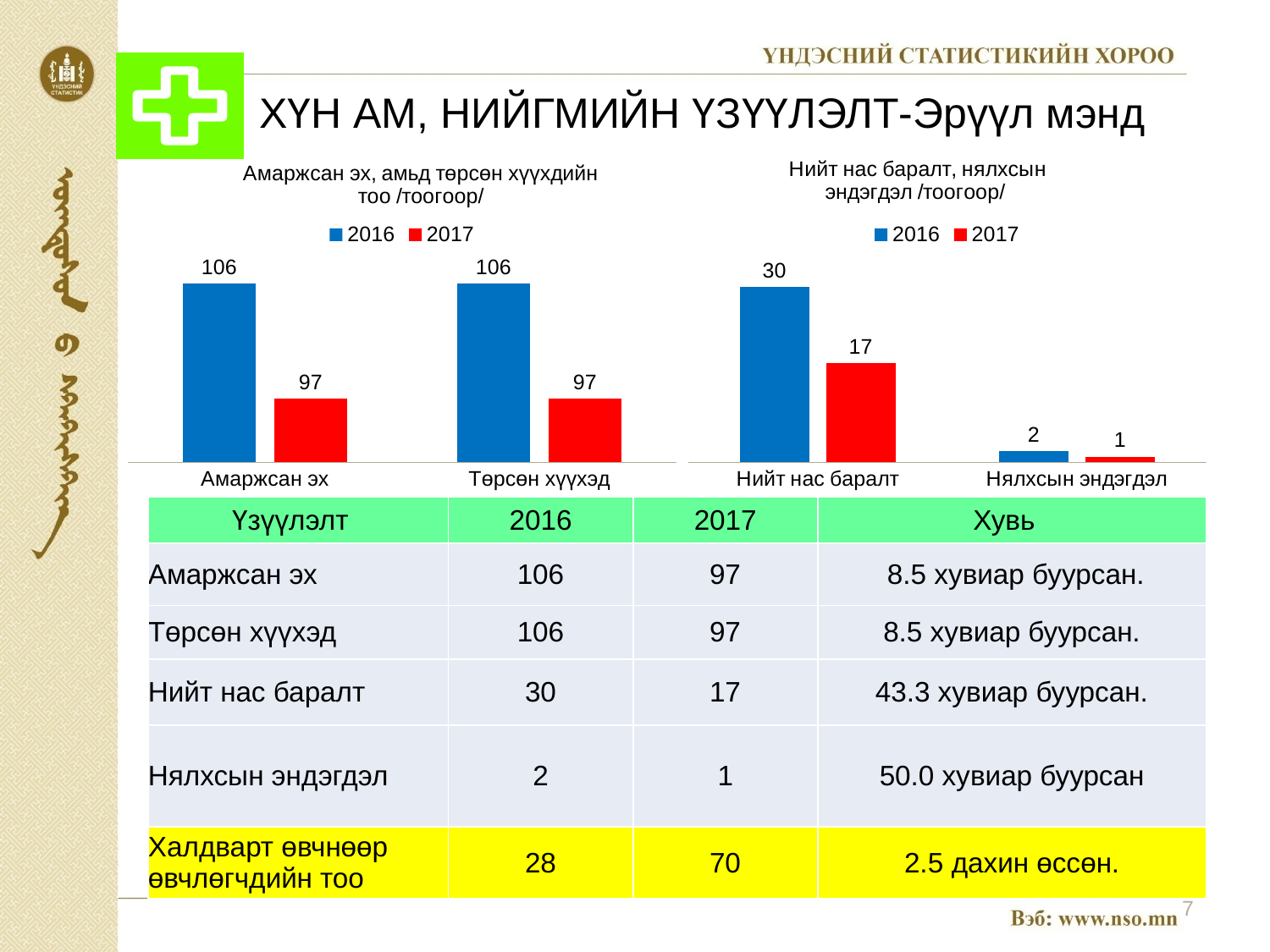
In the left chart (Амаржсан эх, амьд төрсөн хүүхдийн тоо), which series is larger for Төрсөн хүүхэд, 2016 or 2017? 2016 In the right chart (Нийт нас баралт, нялхсын эндэгдэл), which category has the lowest 2017 value? Нялхсын эндэгдэл In the right chart (Нийт нас баралт, нялхсын эндэгдэл), what is the 2017 value for Нялхсын эндэгдэл? 1 In the right chart (Нийт нас баралт, нялхсын эндэгдэл), what is the difference between the 2016 and 2017 values for Нийт нас баралт? 13 In the right chart (Нийт нас баралт, нялхсын эндэгдэл), which colour represents the 2017 series? Red In the left chart (Амаржсан эх, амьд төрсөн хүүхдийн тоо), what is the difference between the 2016 and 2017 values for Амаржсан эх? 9 In the left chart (Амаржсан эх, амьд төрсөн хүүхдийн тоо), what is the 2016 value for Амаржсан эх? 106 What type of chart is the right chart (Нийт нас баралт, нялхсын эндэгдэл)? Bar chart In the left chart (Амаржсан эх, амьд төрсөн хүүхдийн тоо), how many series does the legend list? 2 In the right chart (Нийт нас баралт, нялхсын эндэгдэл), what is the 2016 value for Нийт нас баралт? 30 In the right chart (Нийт нас баралт, нялхсын эндэгдэл), how many categories are shown on the x axis? 2 In the left chart (Амаржсан эх, амьд төрсөн хүүхдийн тоо), what is the 2017 value for Төрсөн хүүхэд? 97